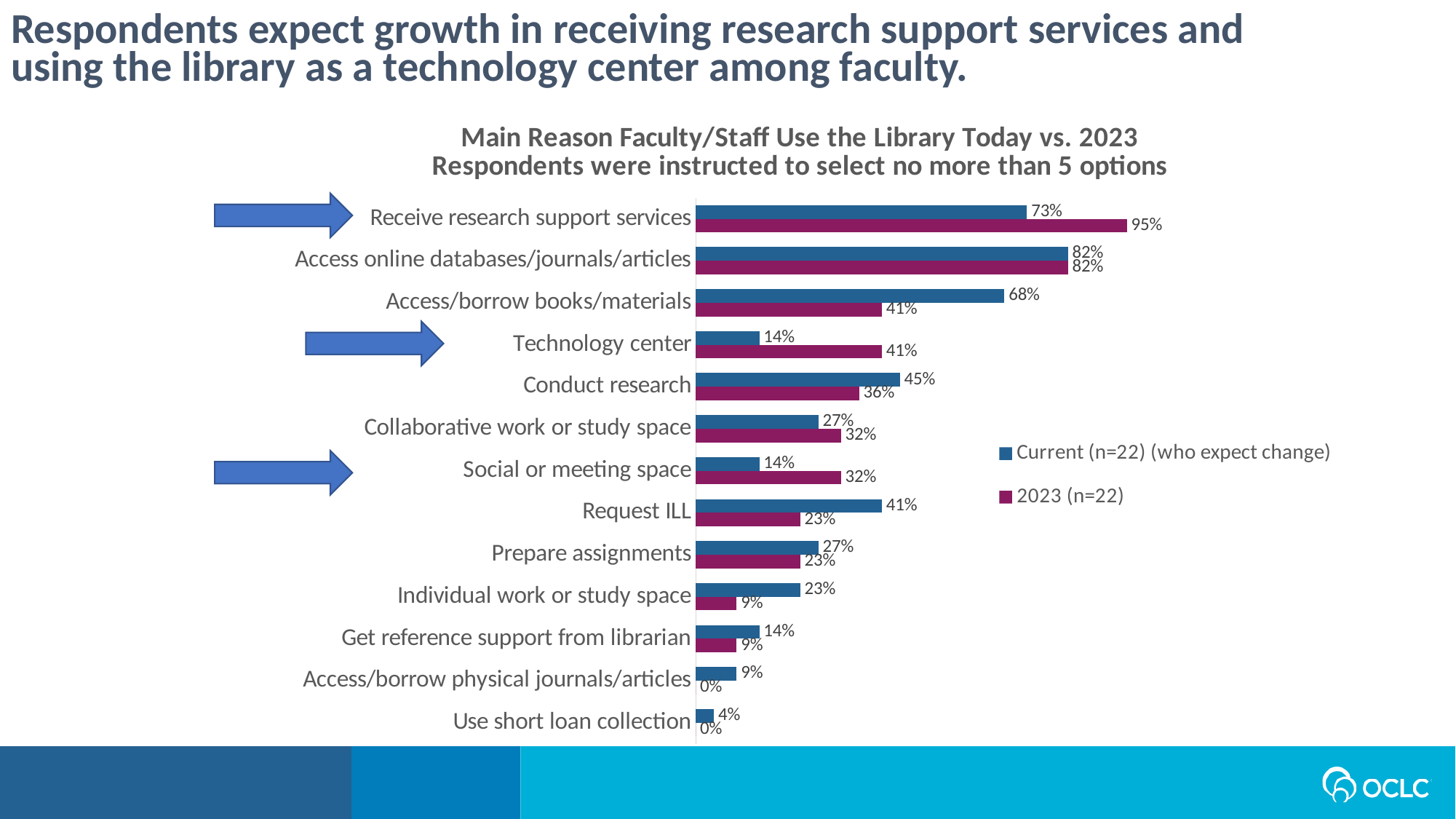
What is the difference between the Current (n=22) (who expect change) and 2023 (n=22) values for Access/borrow books/materials? 27% Which category has the lowest Current (n=22) (who expect change) value? Use short loan collection What is the 2023 (n=22) value for Technology center? 41% What is the title of the chart? Main Reason Faculty/Staff Use the Library Today vs. 2023 Respondents were instructed to select no more than 5 options For Request ILL, which series has the larger value: Current (n=22) (who expect change) or 2023 (n=22)? Current (n=22) (who expect change) What is the Current (n=22) (who expect change) value for Receive research support services? 73% Which category has the highest 2023 (n=22) value? Receive research support services What kind of chart is shown on the slide? Bar chart What is the difference between the 2023 (n=22) and Current (n=22) (who expect change) values for Technology center? 27% How many series does the legend list? 2 How many categories are shown on the chart? 13 What is the 2023 (n=22) value for Access/borrow physical journals/articles? 0%